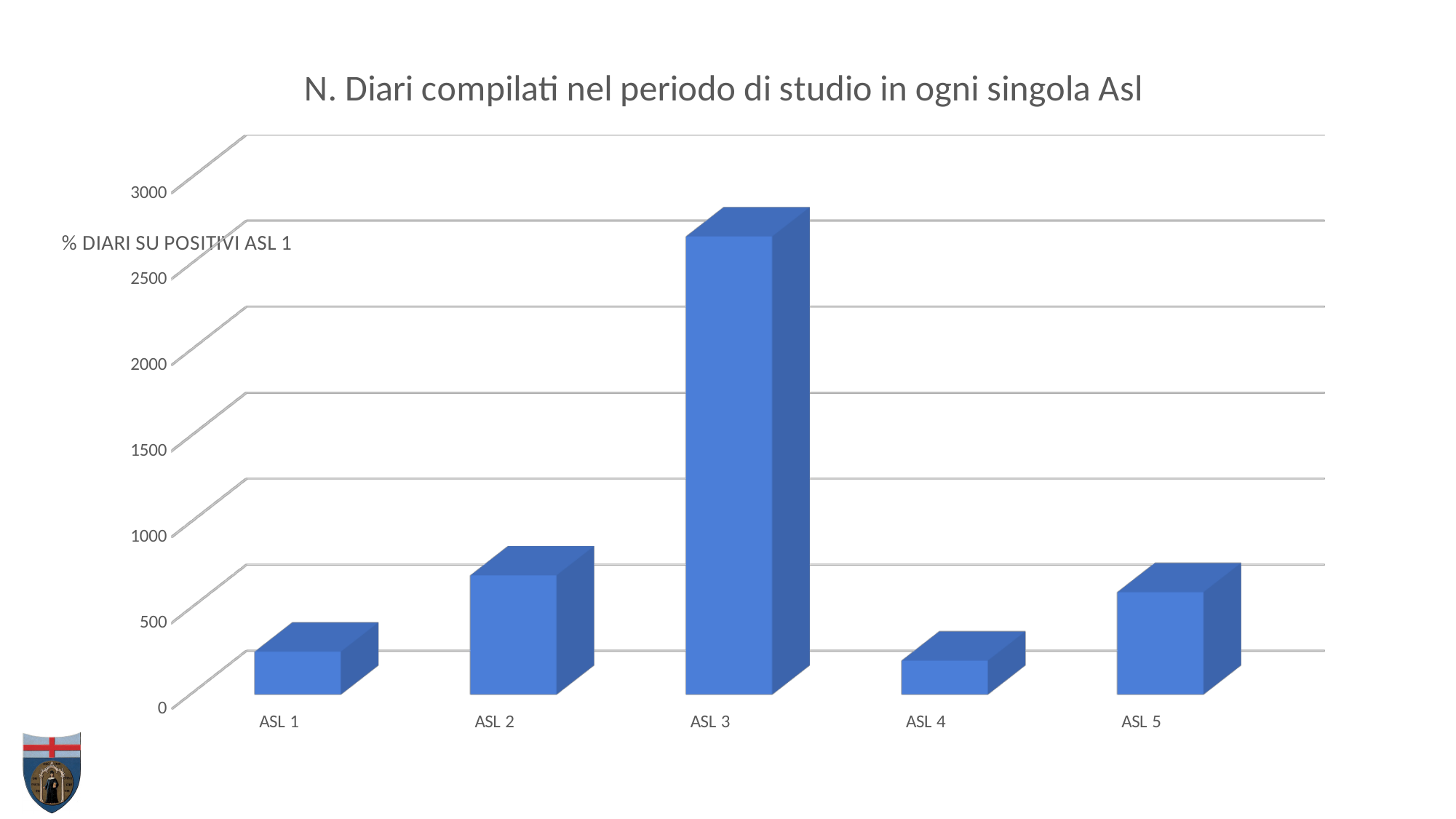
Is the value for ASL 1 greater or less than 500? less Which ASL has the highest number of compiled diaries? ASL 3 Is the value for ASL 4 greater or less than 500? less What is the title of the chart? N. Diari compilati nel periodo di studio in ogni singola Asl Is the value for ASL 3 greater or less than 2000? greater Which is larger, the value for ASL 3 or the value for ASL 2? ASL 3 What kind of chart is shown on the slide? bar chart How many ASL categories are shown on the x axis? 5 What is the highest value shown on the vertical axis? 3000